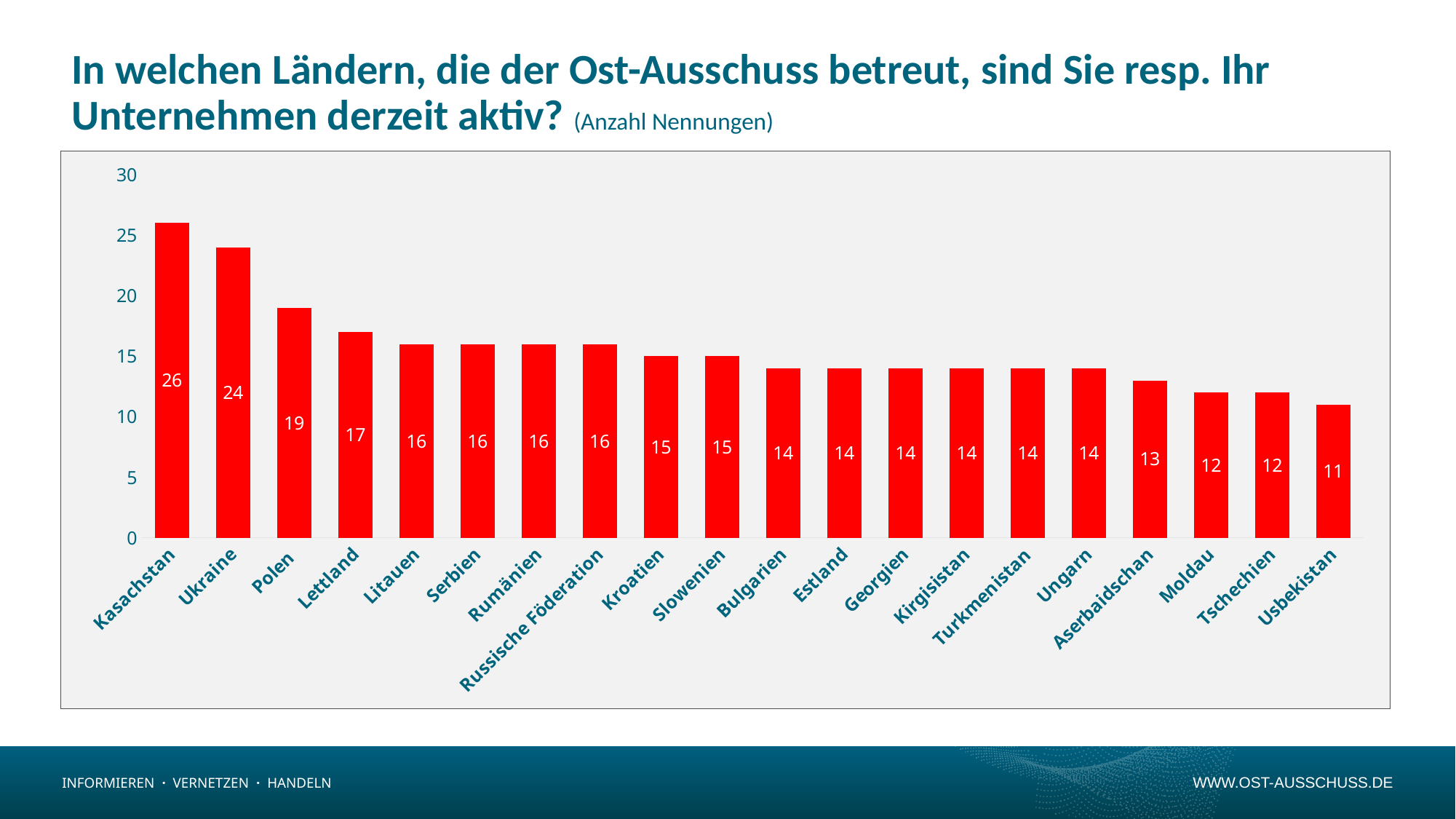
What kind of chart is shown on the slide? Bar chart What is the value for Polen? 19 What is the value for Aserbaidschan? 13 What is the difference between the values for Kasachstan and Ukraine? 2 What is the value for Russische Föderation? 16 What is the difference between the values for Lettland and Moldau? 5 Which country has the highest value? Kasachstan How many countries are shown on the chart? 20 Which country has the lowest value? Usbekistan Do the values rise or fall from left to right along the x axis? Fall What is the value for Kasachstan? 26 Which is larger, the value for Polen or the value for Kroatien? Polen